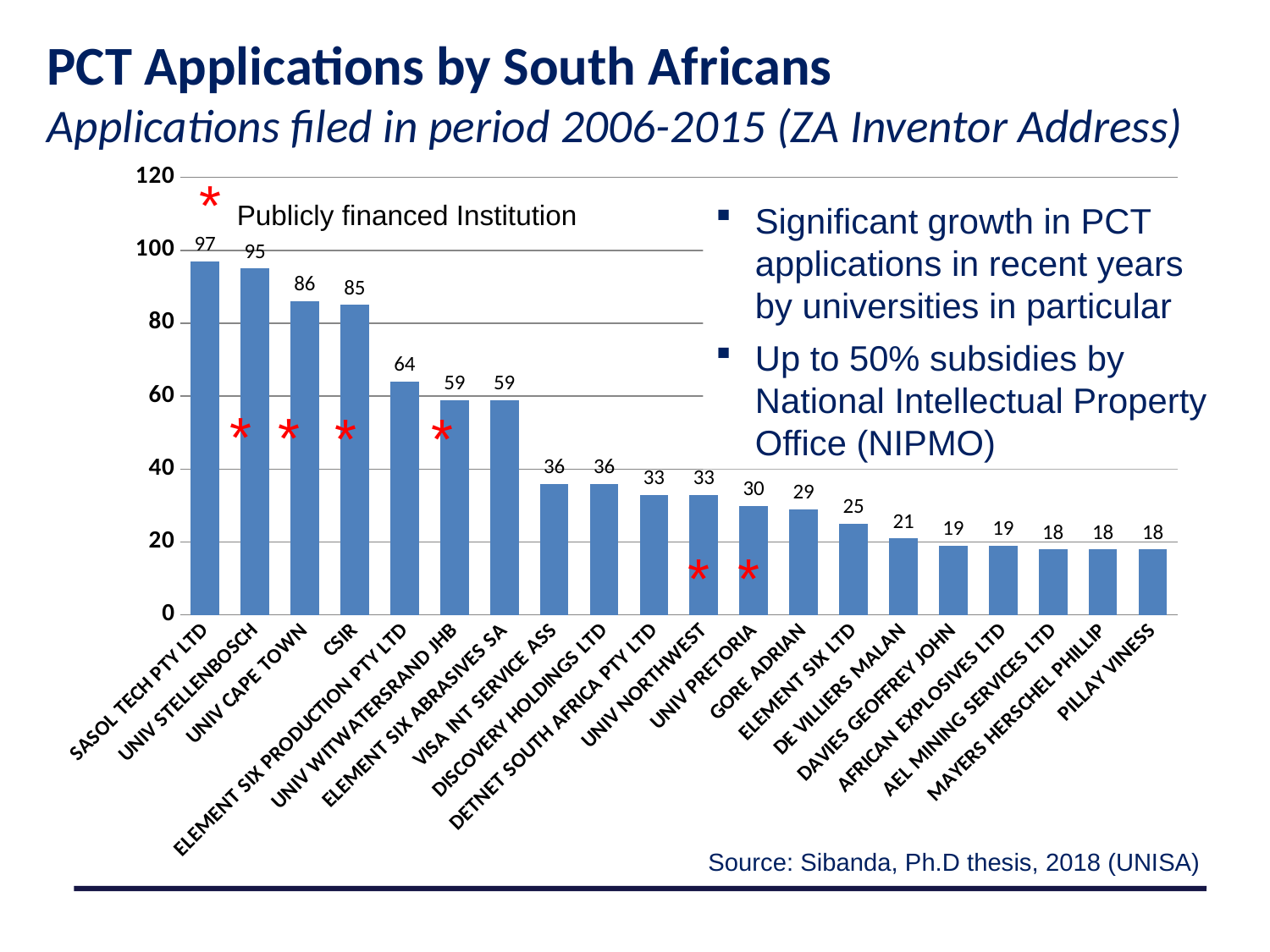
Which has a larger value, CSIR or UNIV NORTHWEST? CSIR What is the value for UNIV CAPE TOWN? 86 Which category has the highest value? SASOL TECH PTY LTD How many PCT applications are shown for SASOL TECH PTY LTD? 97 What is the difference between the values for SASOL TECH PTY LTD and UNIV STELLENBOSCH? 2 What kind of chart is shown on the slide? bar chart How many categories are plotted on the x axis? 20 What is the value for DE VILLIERS MALAN? 21 What is the difference between the values for ELEMENT SIX PRODUCTION PTY LTD and UNIV WITWATERSRAND JHB? 5 What is the value for UNIV PRETORIA? 30 Do the values rise or fall from left to right along the x axis? fall According to the chart annotation, what does the red asterisk mark? Publicly financed Institution